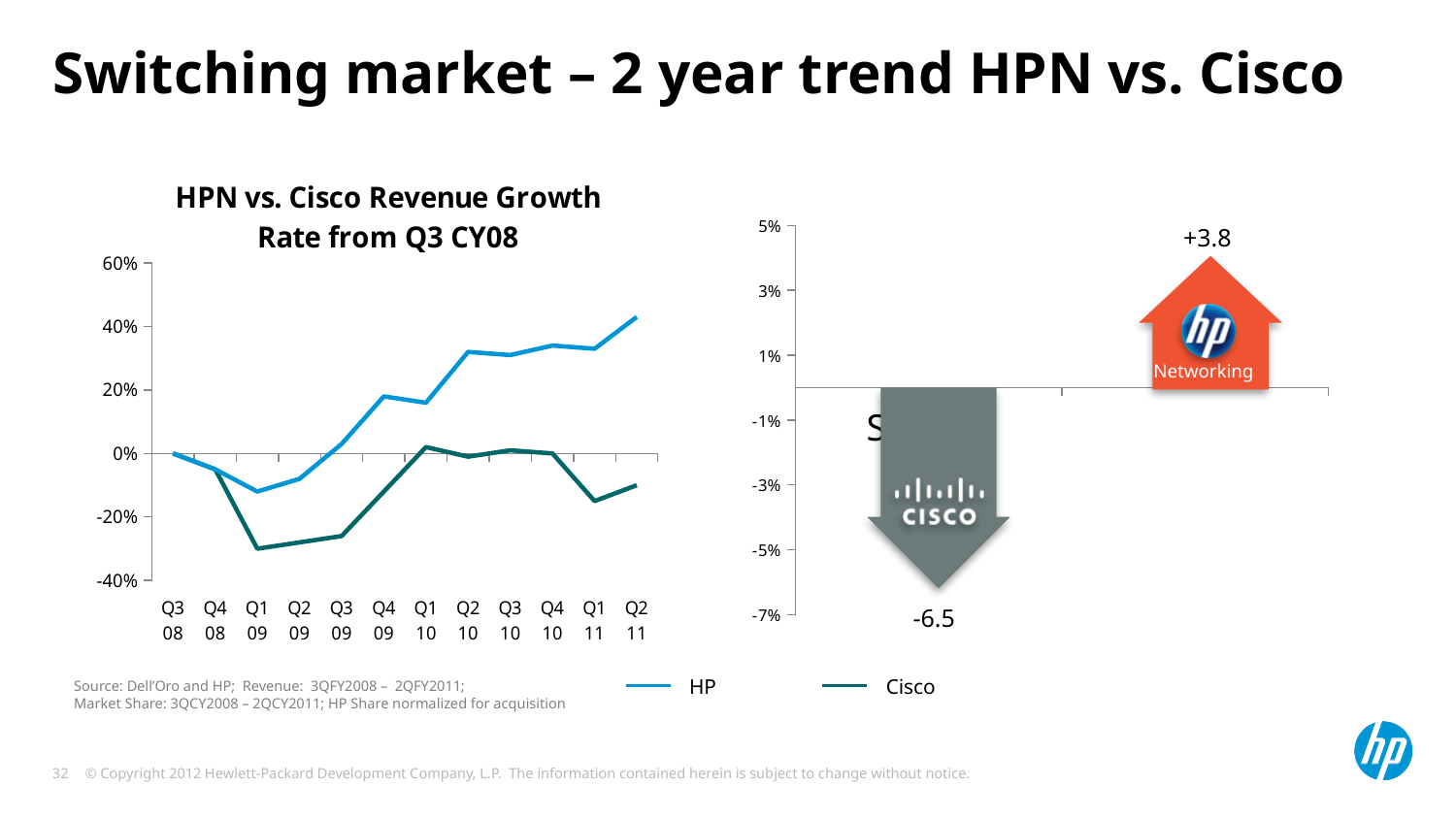
In the 'HPN vs. Cisco Revenue Growth Rate from Q3 CY08' chart, does the HP line generally rise or fall from Q1 09 to Q2 11? Rise In the 'HPN vs. Cisco Revenue Growth Rate from Q3 CY08' chart, which series has the higher value in Q2 11, HP or Cisco? HP In the chart on the right of the slide, what is the difference between the HP Networking value and the Cisco value? 10.3 In the 'HPN vs. Cisco Revenue Growth Rate from Q3 CY08' chart, in which quarter does the HP line reach its highest value? Q2 11 In the 'HPN vs. Cisco Revenue Growth Rate from Q3 CY08' chart, is the HP value for Q2 11 greater or less than 20%? greater What type of chart is the 'HPN vs. Cisco Revenue Growth Rate from Q3 CY08' chart? Line chart In the chart on the right of the slide, what value is shown for Cisco? -6.5 How many series does the legend of the 'HPN vs. Cisco Revenue Growth Rate from Q3 CY08' chart list? 2 In the 'HPN vs. Cisco Revenue Growth Rate from Q3 CY08' chart, is the Cisco value for Q1 09 greater or less than -20%? less In the 'HPN vs. Cisco Revenue Growth Rate from Q3 CY08' chart, in which quarter does the Cisco line reach its lowest value? Q1 09 How many quarters are plotted along the x axis of the 'HPN vs. Cisco Revenue Growth Rate from Q3 CY08' chart? 12 In the chart on the right of the slide, what value is shown for HP Networking? +3.8